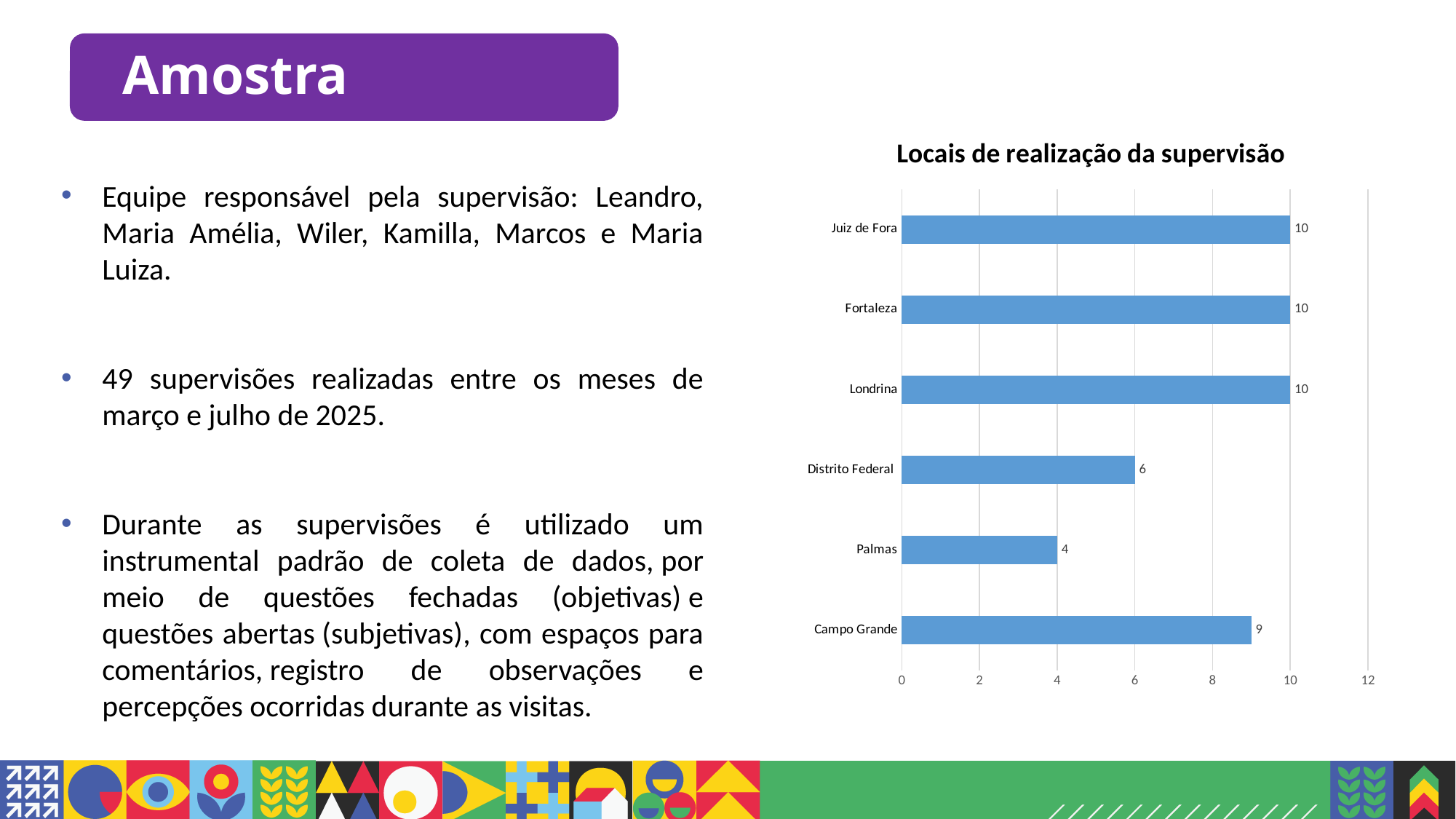
How many locations are shown in the chart? 6 What kind of chart is shown on the slide? Bar chart What is the value for Campo Grande? 9 What is the value for Distrito Federal? 6 What is the value for Londrina? 10 Which location has the lowest value? Palmas What is the title of the chart? Locais de realização da supervisão What is the difference between the values for Fortaleza and Distrito Federal? 4 What is the value for Palmas? 4 Which is larger, the value for Campo Grande or the value for Distrito Federal? Campo Grande What is the difference between the values for Campo Grande and Palmas? 5 What is the total of all the values shown in the chart? 49